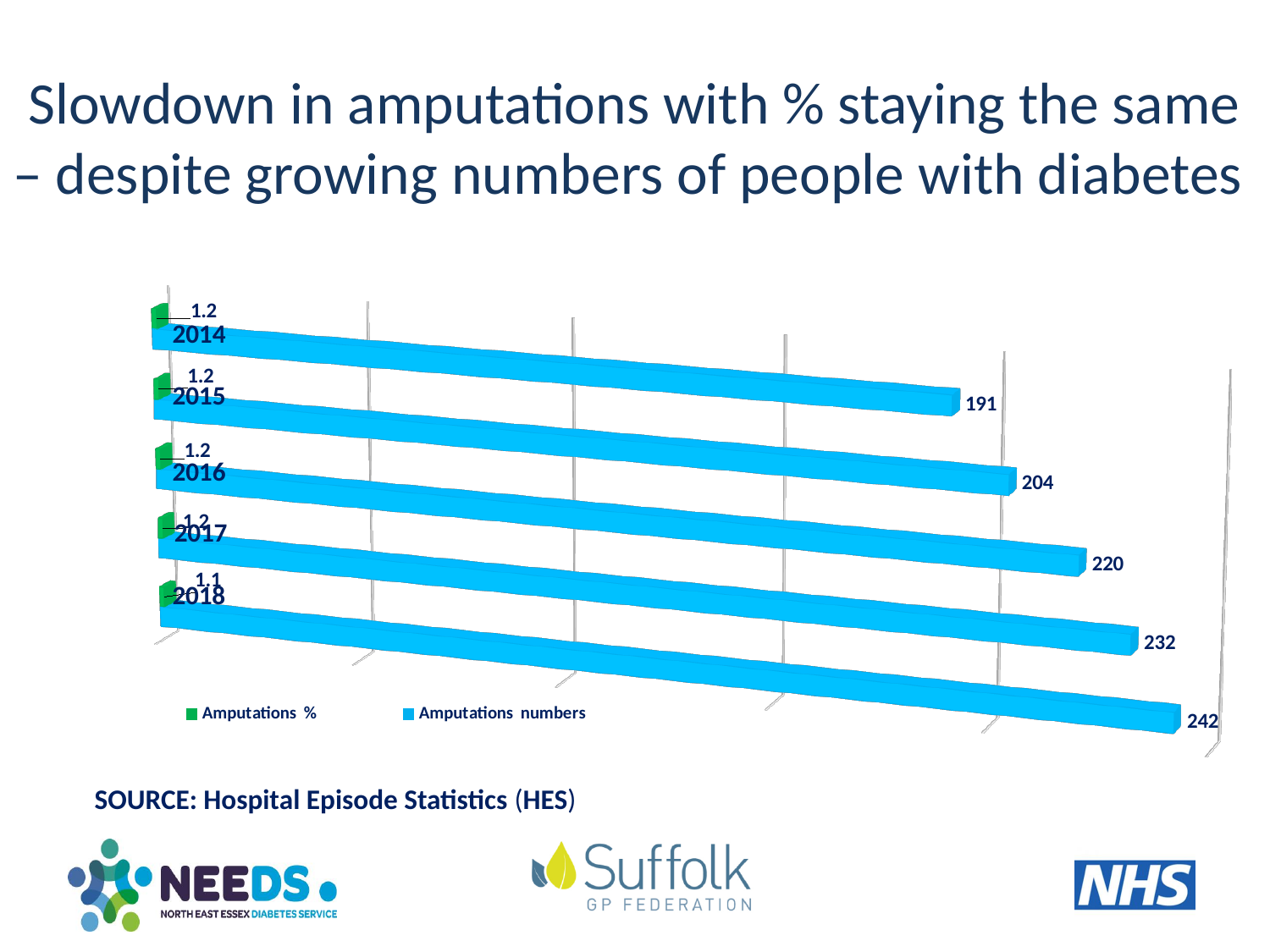
What is the Amputations % value for 2018? 1.1 What kind of chart is shown on the slide? Bar chart What is the value of Amputations numbers for 2014? 191 Which is larger, the Amputations numbers for 2015 or for 2017? 2017 What is the difference in Amputations numbers between 2018 and 2014? 51 What is the value of Amputations numbers for 2016? 220 What is the difference in Amputations numbers between 2017 and 2015? 28 Which year has the lowest Amputations numbers? 2014 What is the value of Amputations numbers for 2018? 242 How many series does the legend list? 2 Which year has the highest Amputations numbers? 2018 How many years are shown on the chart? 5